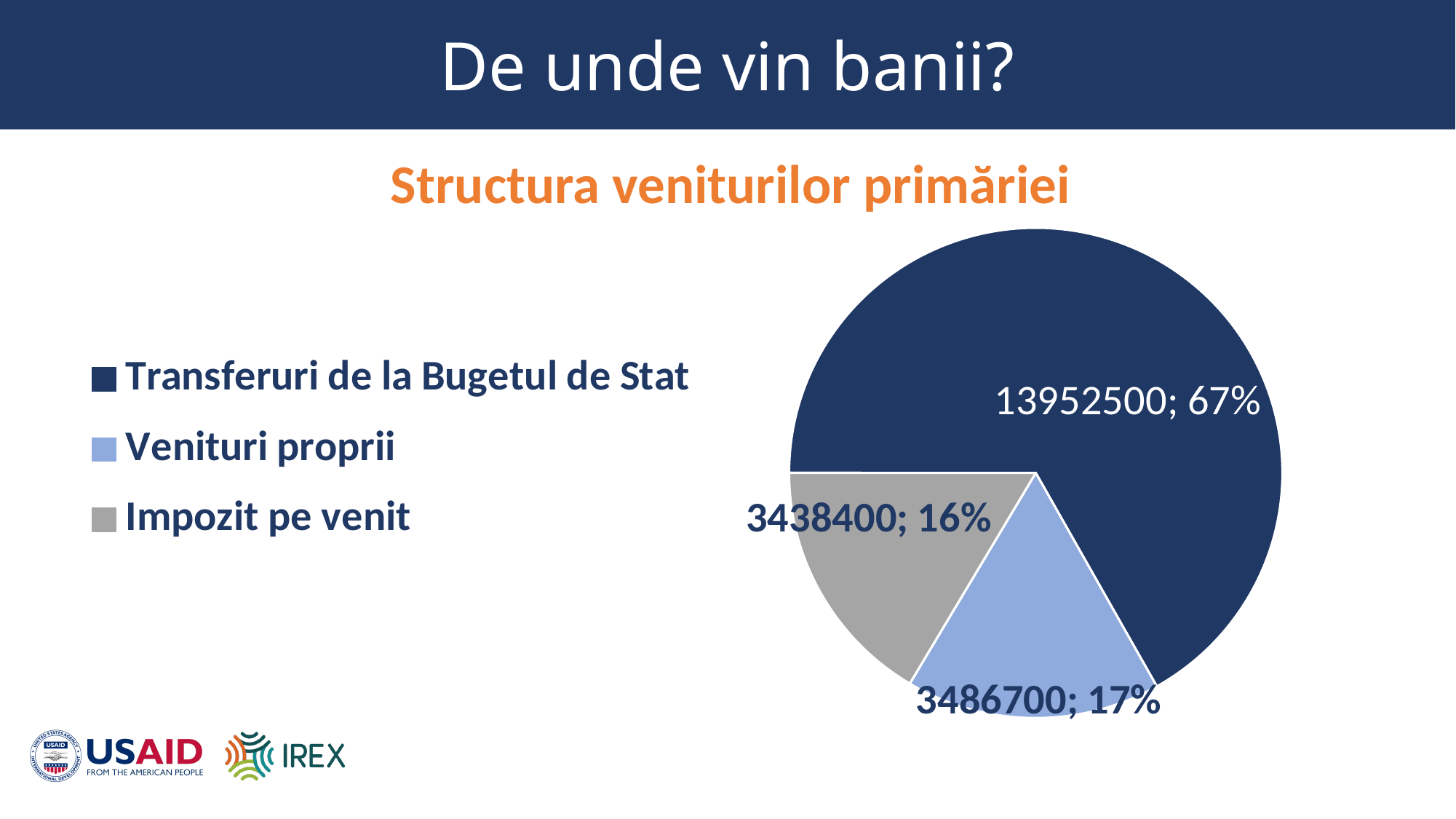
What is the value for Transferuri de la Bugetul de Stat? 13952500 What is the difference between the values for Transferuri de la Bugetul de Stat and Venituri proprii? 10465800 What share of the pie does Transferuri de la Bugetul de Stat represent? 67% What type of chart is shown on the slide? Pie chart What is the value for Venituri proprii? 3486700 How many categories does the pie chart show? 3 Which is larger, the value for Venituri proprii or the value for Impozit pe venit? Venituri proprii Which category has the smallest slice? Impozit pe venit What is the difference between the values for Venituri proprii and Impozit pe venit? 48300 What share of the pie does Impozit pe venit represent? 16% What is the value for Impozit pe venit? 3438400 Which category has the largest slice? Transferuri de la Bugetul de Stat